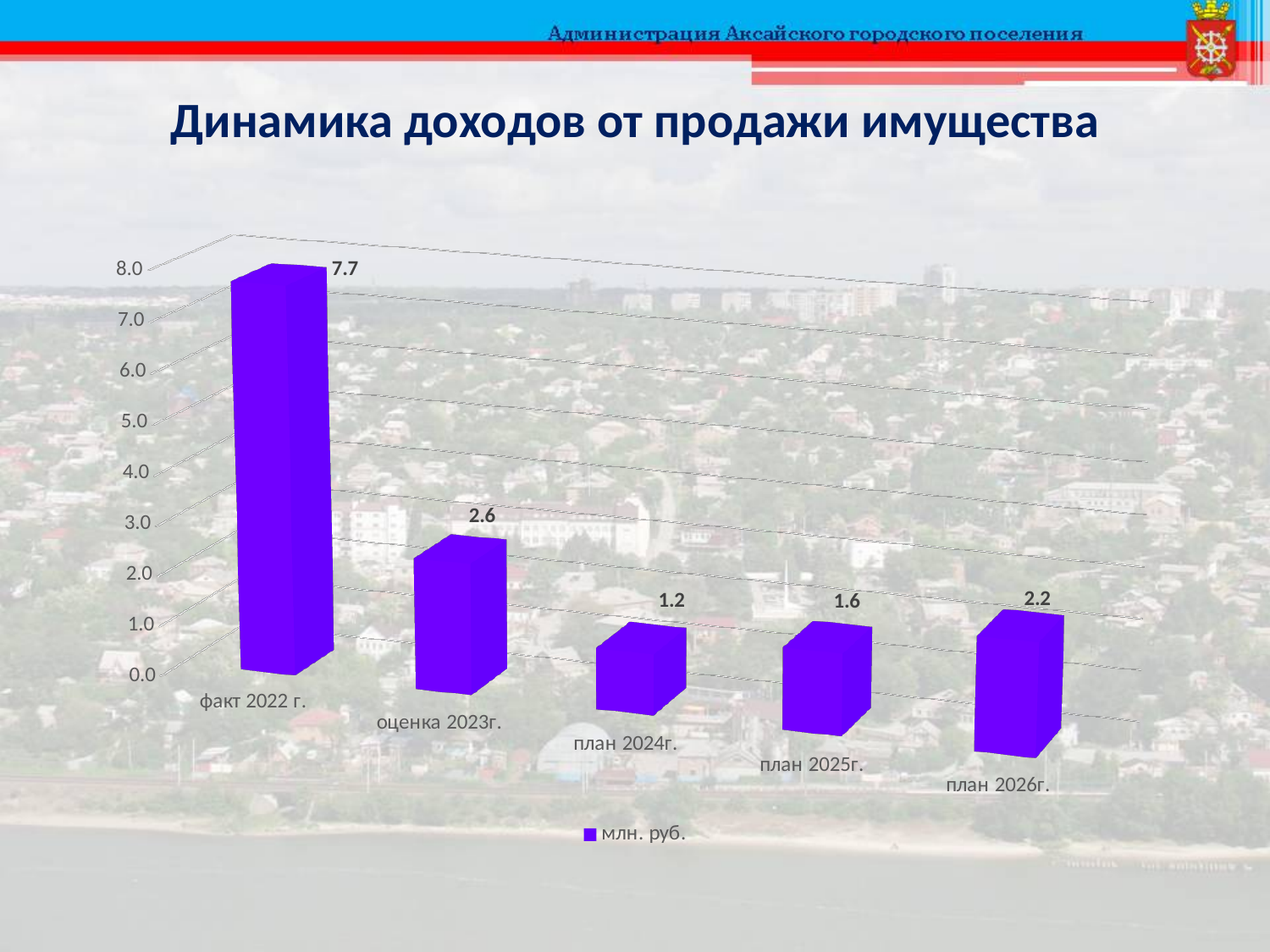
What is the title of the chart? Динамика доходов от продажи имущества Which category has the highest value? факт 2022 г. What is the value for оценка 2023г.? 2.6 Which category has the lowest value? план 2024г. What is the value for факт 2022 г.? 7.7 What is the value for план 2024г.? 1.2 What is the value for план 2026г.? 2.2 What is the difference between the values for факт 2022 г. and оценка 2023г.? 5.1 What series name does the legend show? млн. руб. What kind of chart is shown on the slide? bar chart Which is larger, the value for план 2025г. or the value for план 2026г.? план 2026г. How many categories are shown on the chart? 5